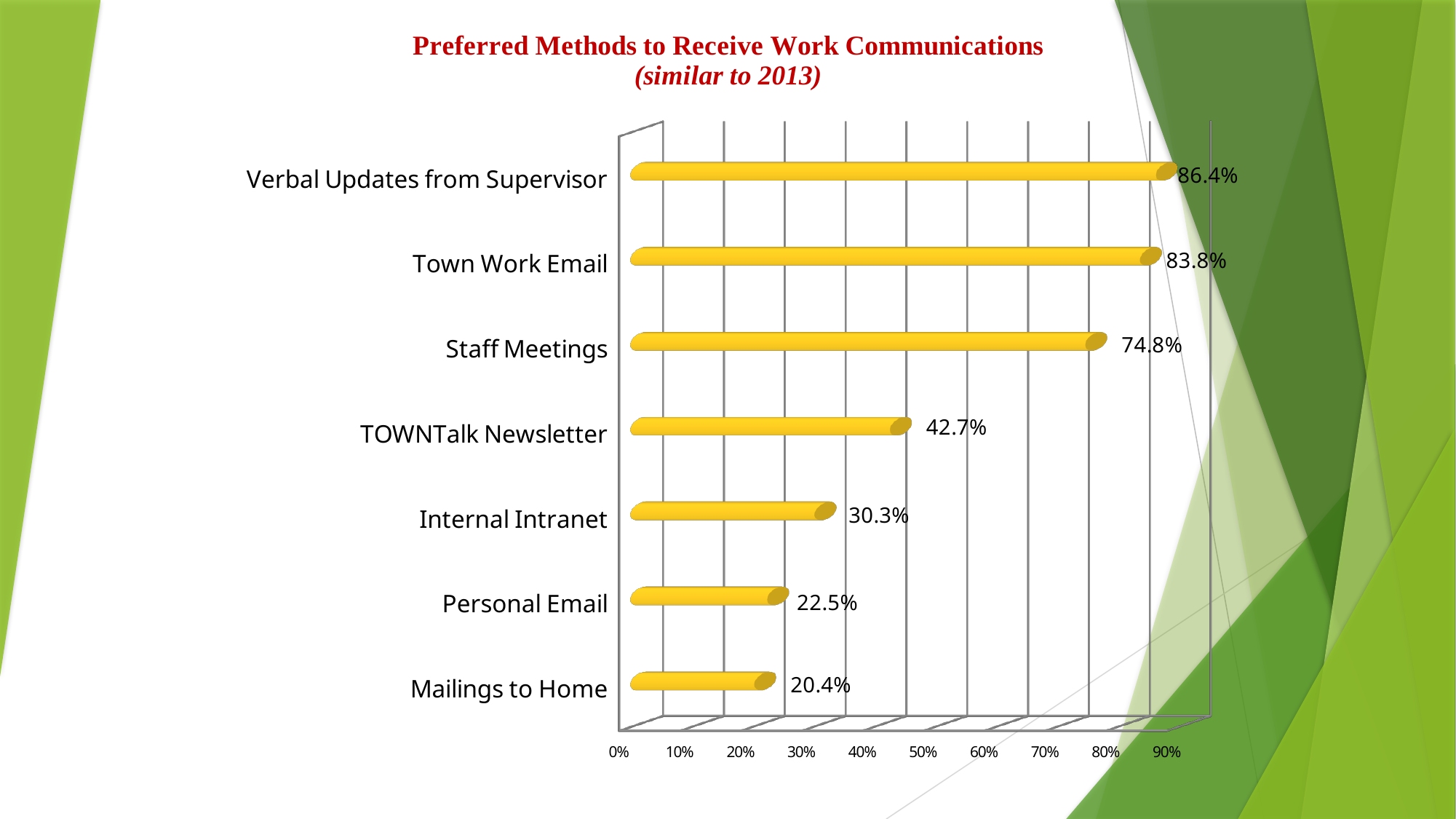
Is the value for Staff Meetings greater or less than 70%? greater How many categories are shown in the chart? 7 What kind of chart is shown on the slide? bar chart What is the difference between the values for Staff Meetings and TOWNTalk Newsletter? 32.1% What is the title of the chart? Preferred Methods to Receive Work Communications (similar to 2013) Which category has the lowest value? Mailings to Home Which is larger, the value for Staff Meetings or the value for Internal Intranet? Staff Meetings What is the value for Town Work Email? 83.8% What is the difference between the values for Personal Email and Mailings to Home? 2.1% Which category has the highest value? Verbal Updates from Supervisor What is the value for Internal Intranet? 30.3% What is the value for TOWNTalk Newsletter? 42.7%